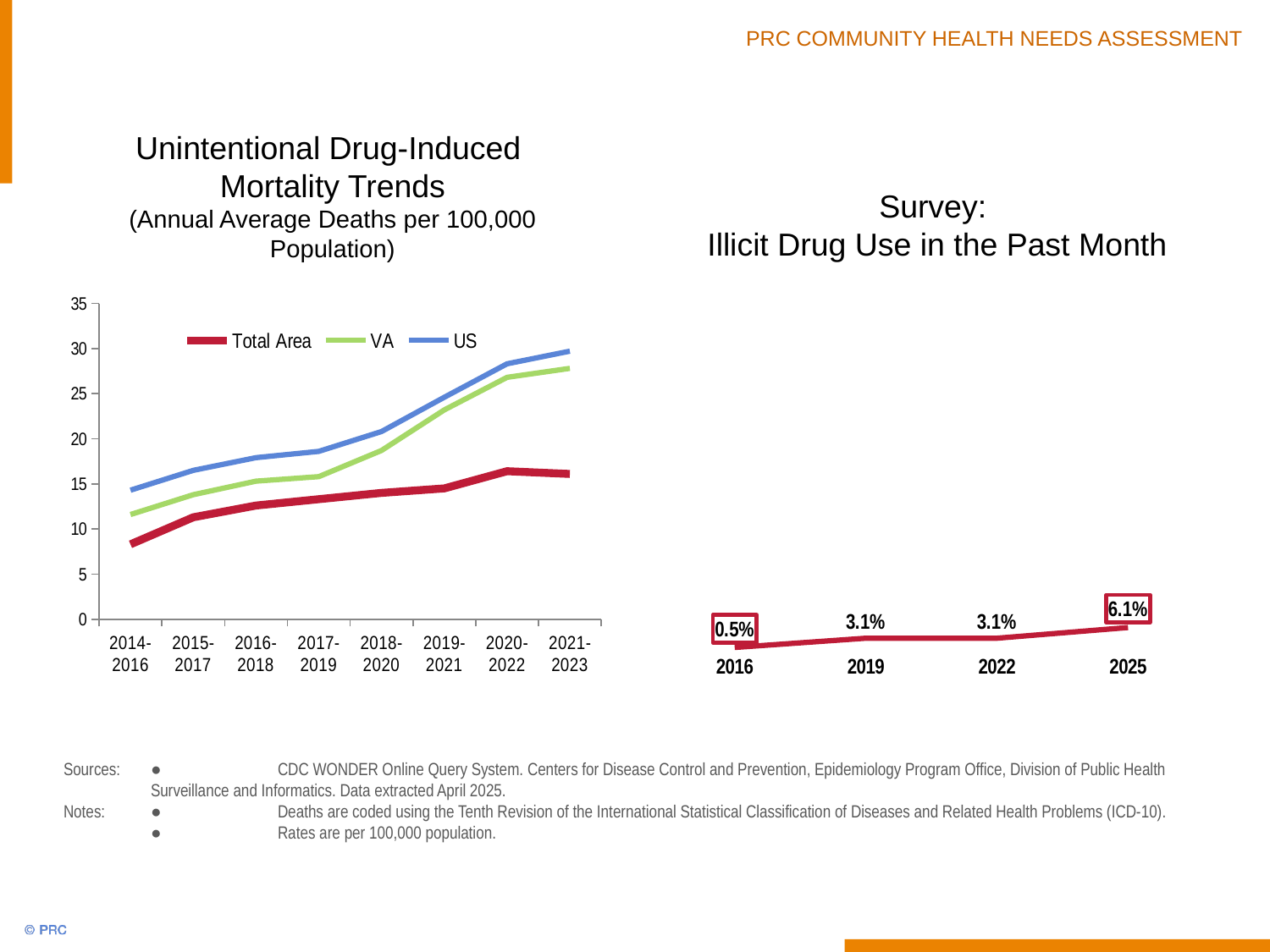
In the 'Unintentional Drug-Induced Mortality Trends' chart, does the US line rise or fall from 2014-2016 to 2021-2023? rise In the 'Unintentional Drug-Induced Mortality Trends' chart, is the Total Area value for 2014-2016 greater or less than 10? less In the 'Unintentional Drug-Induced Mortality Trends' chart, which series is drawn in red? Total Area In the 'Unintentional Drug-Induced Mortality Trends' chart, which series has the highest value in 2021-2023? US How many data points are plotted in the 'Survey: Illicit Drug Use in the Past Month' chart? 4 In the 'Survey: Illicit Drug Use in the Past Month' chart, what is the value for 2016? 0.5% In the 'Unintentional Drug-Induced Mortality Trends' chart, is the US value for 2021-2023 greater or less than 25? greater How many series does the legend of the 'Unintentional Drug-Induced Mortality Trends' chart list? 3 What kind of chart is the 'Unintentional Drug-Induced Mortality Trends' chart on the left? line chart In the 'Survey: Illicit Drug Use in the Past Month' chart, which year has the highest value? 2025 How many time periods are shown on the x axis of the 'Unintentional Drug-Induced Mortality Trends' chart? 8 In the 'Survey: Illicit Drug Use in the Past Month' chart, what is the difference between the 2025 value and the 2016 value? 5.6%